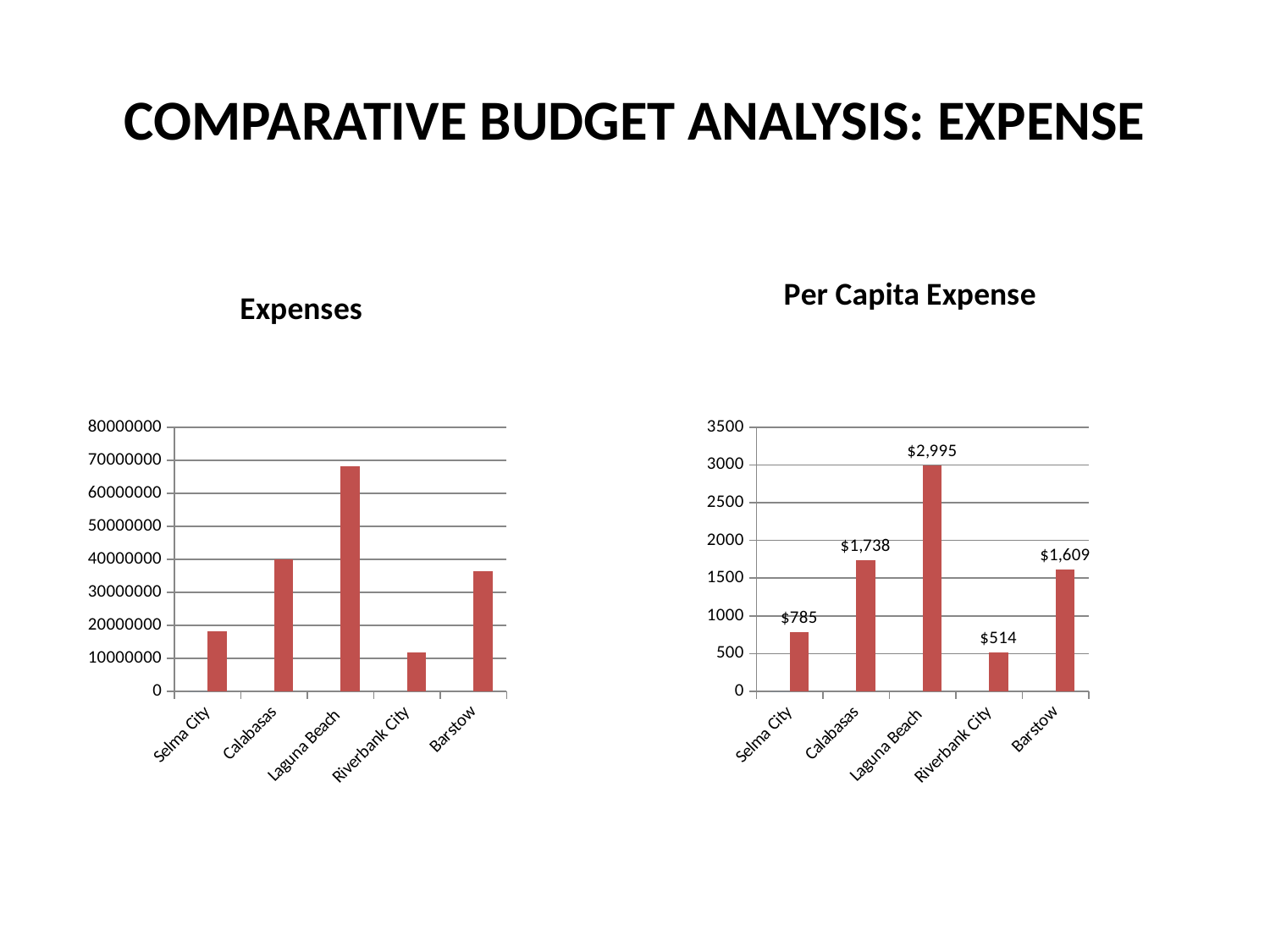
In the Per Capita Expense chart, what is the value for Riverbank City? $514 In the Per Capita Expense chart, what is the value for Barstow? $1,609 In the Per Capita Expense chart, what is the value for Laguna Beach? $2,995 In the Expenses chart, is the value for Calabasas greater or less than 30000000? greater In the Per Capita Expense chart, which city has the lowest per capita expense? Riverbank City In the Per Capita Expense chart, which city has the highest per capita expense? Laguna Beach In the Expenses chart, which city has the lowest expenses? Riverbank City What type of chart is the Per Capita Expense chart? Bar chart How many cities are shown in the Expenses chart? 5 In the Expenses chart, which city has the highest expenses? Laguna Beach In the Per Capita Expense chart, what is the difference between Calabasas and Selma City? $953 In the Per Capita Expense chart, which is larger, Calabasas or Barstow? Calabasas